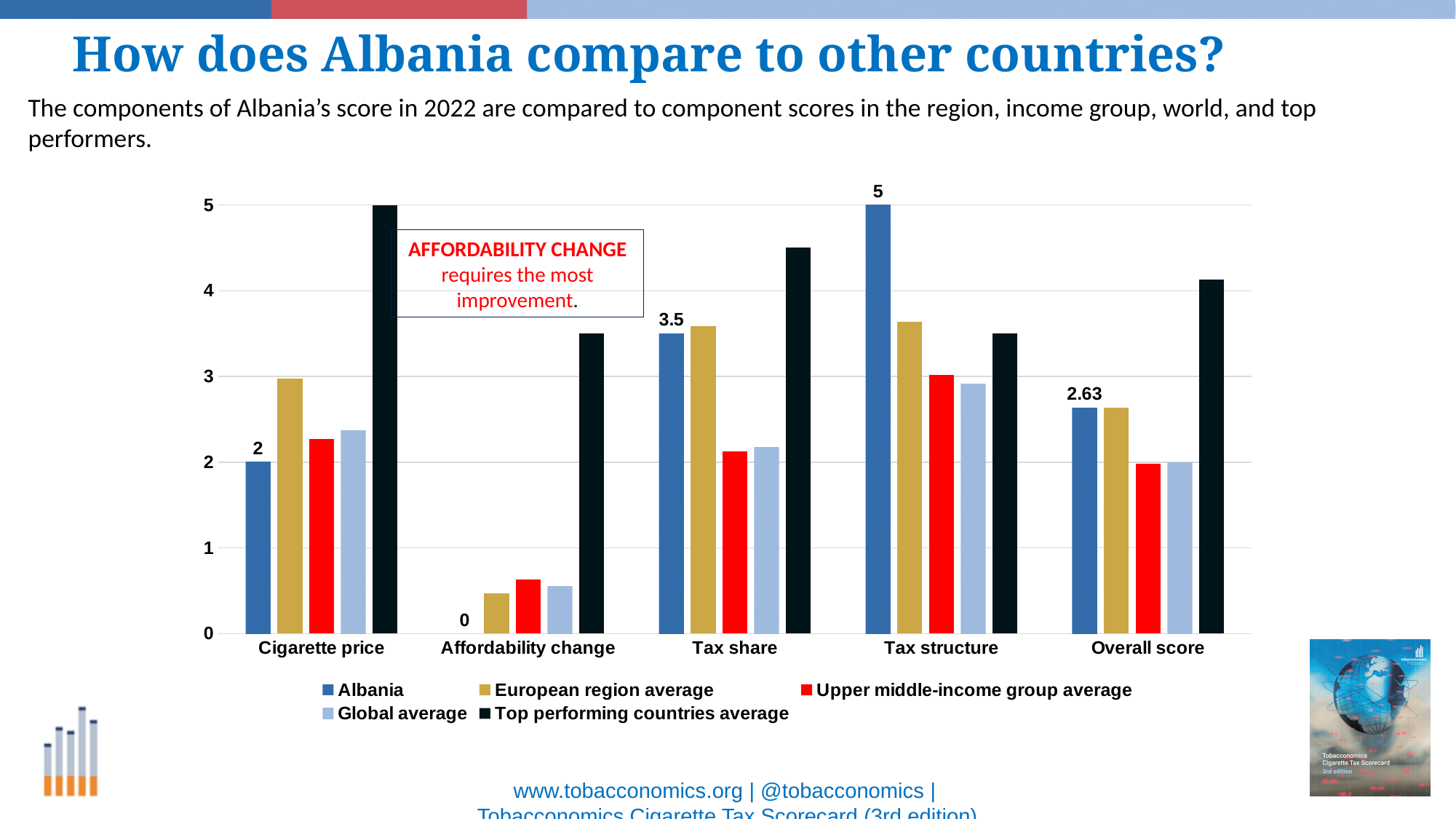
What is Albania's value for Overall score? 2.63 Is the Upper middle-income group average for Tax share greater or less than 3? less Which is larger for Albania: Tax share or Overall score? Tax share In which category does Albania have its lowest value? Affordability change How many series does the legend list? 5 What is Albania's value for Affordability change? 0 How many categories are shown on the x axis? 5 What is Albania's value for Tax share? 3.5 What is the difference between Albania's Tax structure value and its Cigarette price value? 3 In which category does Albania have its highest value? Tax structure What is Albania's value for Cigarette price? 2 Is the Top performing countries average for Affordability change greater or less than 3? greater